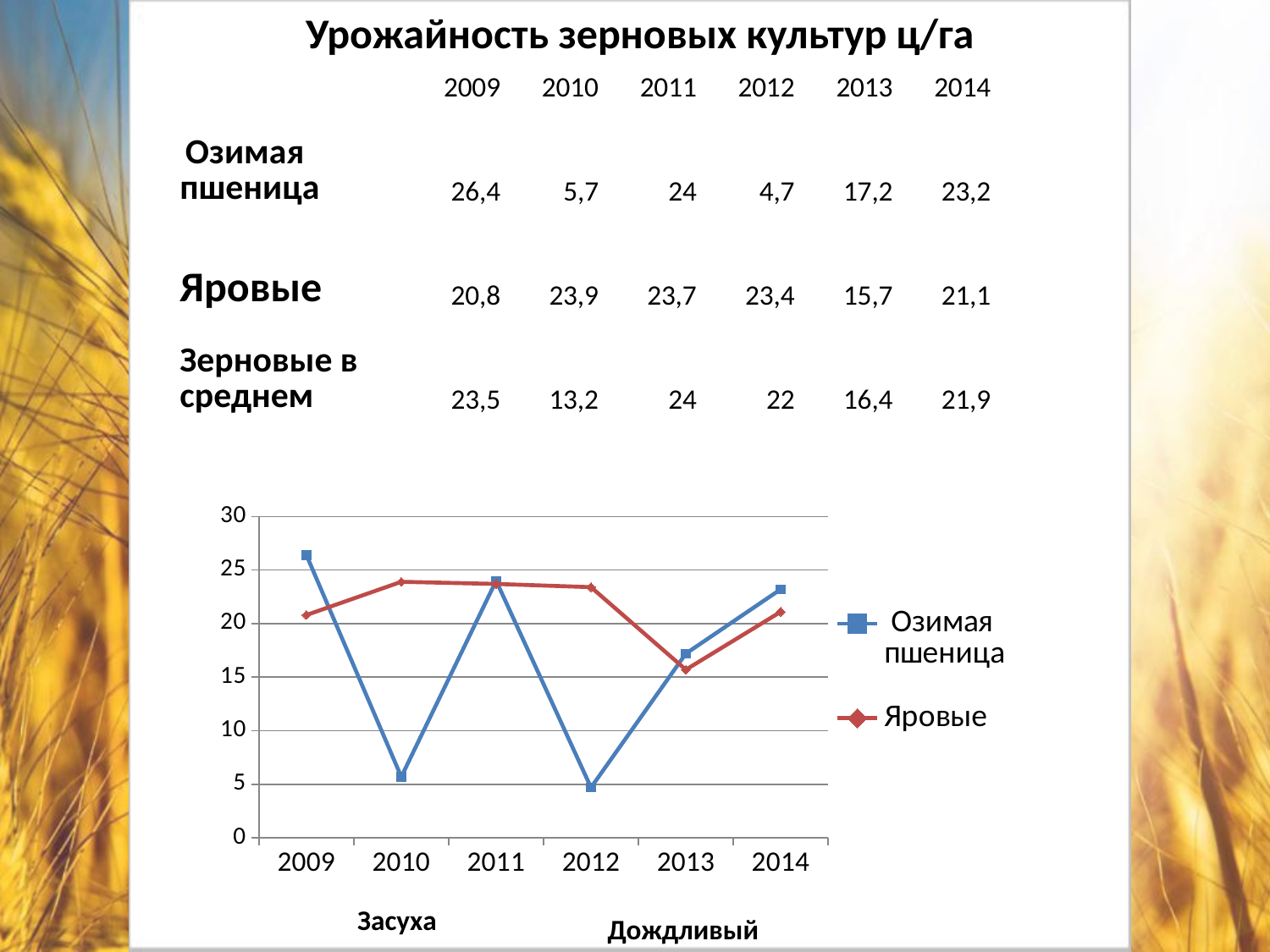
How many series does the chart legend list? 2 In which year is the value for Яровые the lowest? 2013 What is the value for Яровые in 2013? 15,7 In which year is the value for Озимая пшеница the highest? 2009 How many years are plotted along the x axis of the chart? 6 What kind of chart is shown on the slide? line chart Does the Озимая пшеница line rise or fall from 2012 to 2014? rises Is the value for Яровые in 2011 greater or less than 20? greater What is the value for Озимая пшеница in 2010? 5,7 In 2009, which series has the larger value, Озимая пшеница or Яровые? Озимая пшеница What is the difference between Яровые and Озимая пшеница in 2012? 18,7 In which year is the value for Озимая пшеница the lowest? 2012